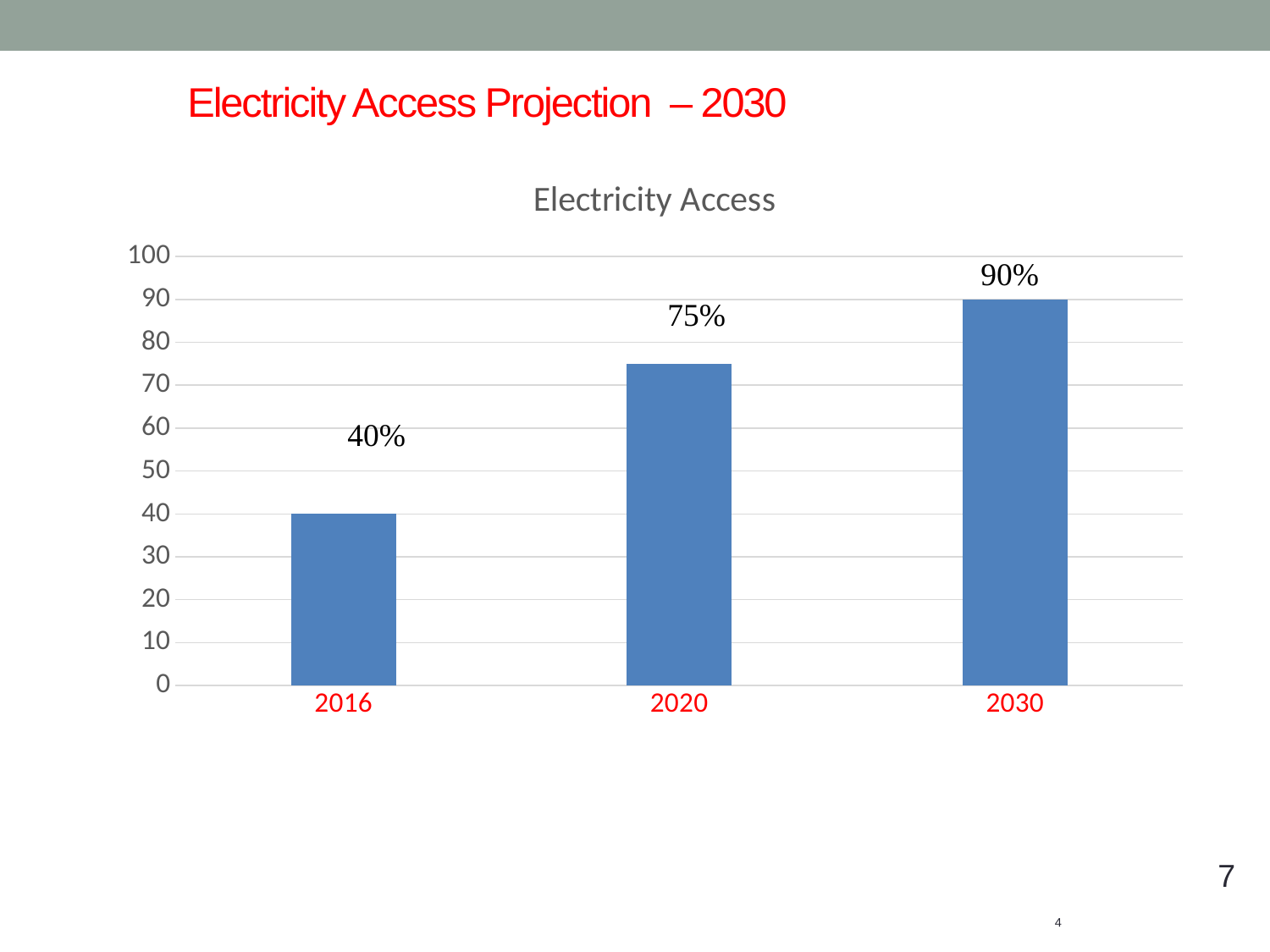
How many years are shown on the x axis of the chart? 3 What is the difference between the electricity access values for 2030 and 2016? 50% What is the difference between the electricity access values for 2020 and 2016? 35% Which year has the highest electricity access value? 2030 Which year has the lowest electricity access value? 2016 Which is larger, the value for 2020 or the value for 2030? 2030 What is the electricity access value for 2020? 75% Is the value for 2020 greater or less than 70? greater What is the electricity access value for 2030? 90% Do the values rise or fall from 2016 to 2030? Rise What is the electricity access value for 2016? 40% What kind of chart is shown on the slide? Bar chart